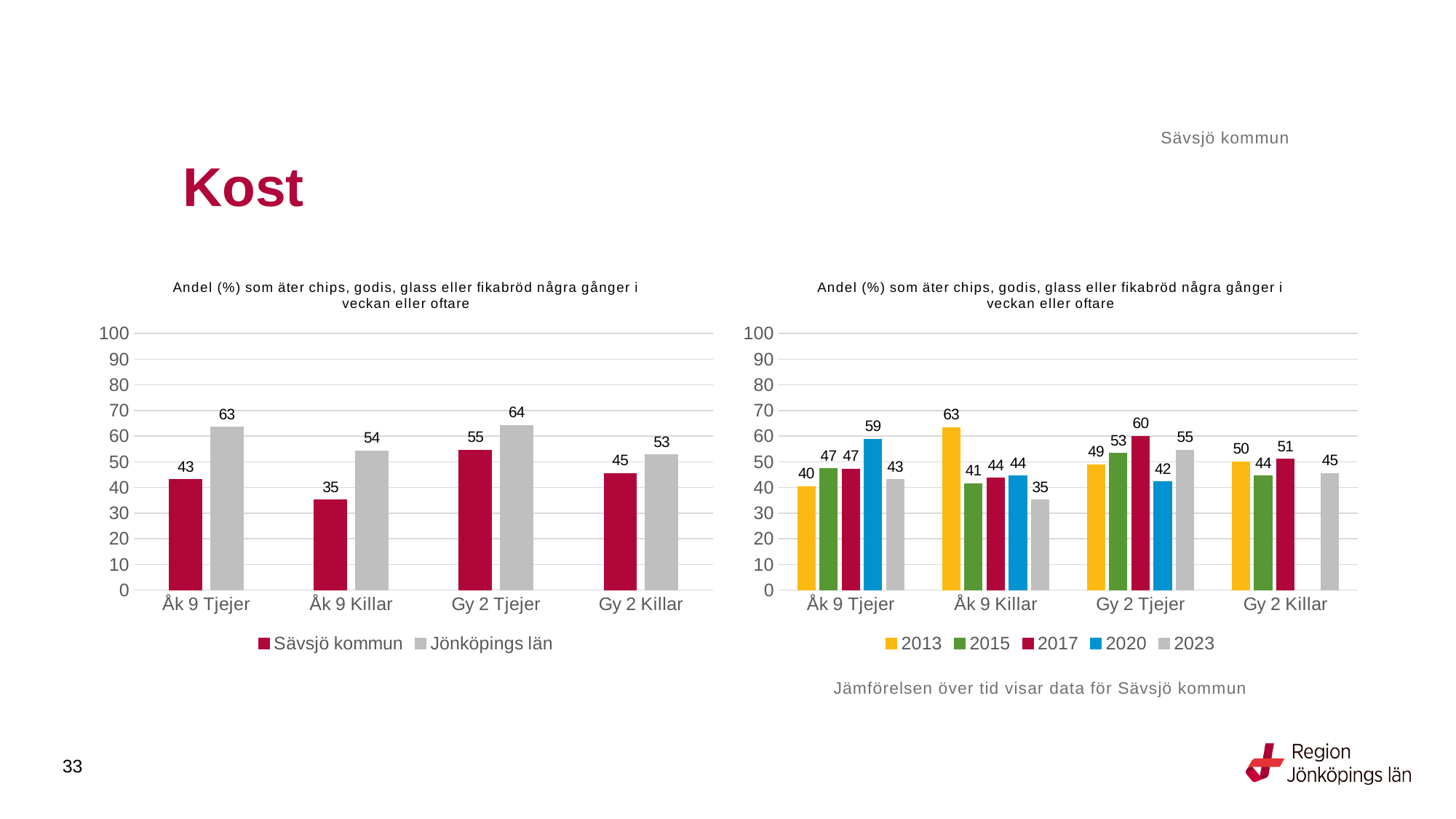
In the left chart, what is the value for Sävsjö kommun for Åk 9 Killar? 35 In the left chart, which category has the highest value for Sävsjö kommun? Gy 2 Tjejer In the right chart, what is the value for 2013 for Åk 9 Killar? 63 In the right chart, which is larger for Gy 2 Tjejer: the value for 2017 or the value for 2020? 2017 In the left chart, what is the value for Jönköpings län for Gy 2 Tjejer? 64 In the right chart, how many series does the legend list? 5 What kind of chart is the right chart? Bar chart In the right chart, which year has the lowest value for Åk 9 Killar? 2023 In the left chart, how many series does the legend list? 2 In the left chart, what is the difference between Jönköpings län and Sävsjö kommun for Åk 9 Tjejer? 20 In the right chart, what is the value for 2020 for Åk 9 Tjejer? 59 In the right chart, what is the difference between the 2023 and 2013 values for Gy 2 Tjejer? 6